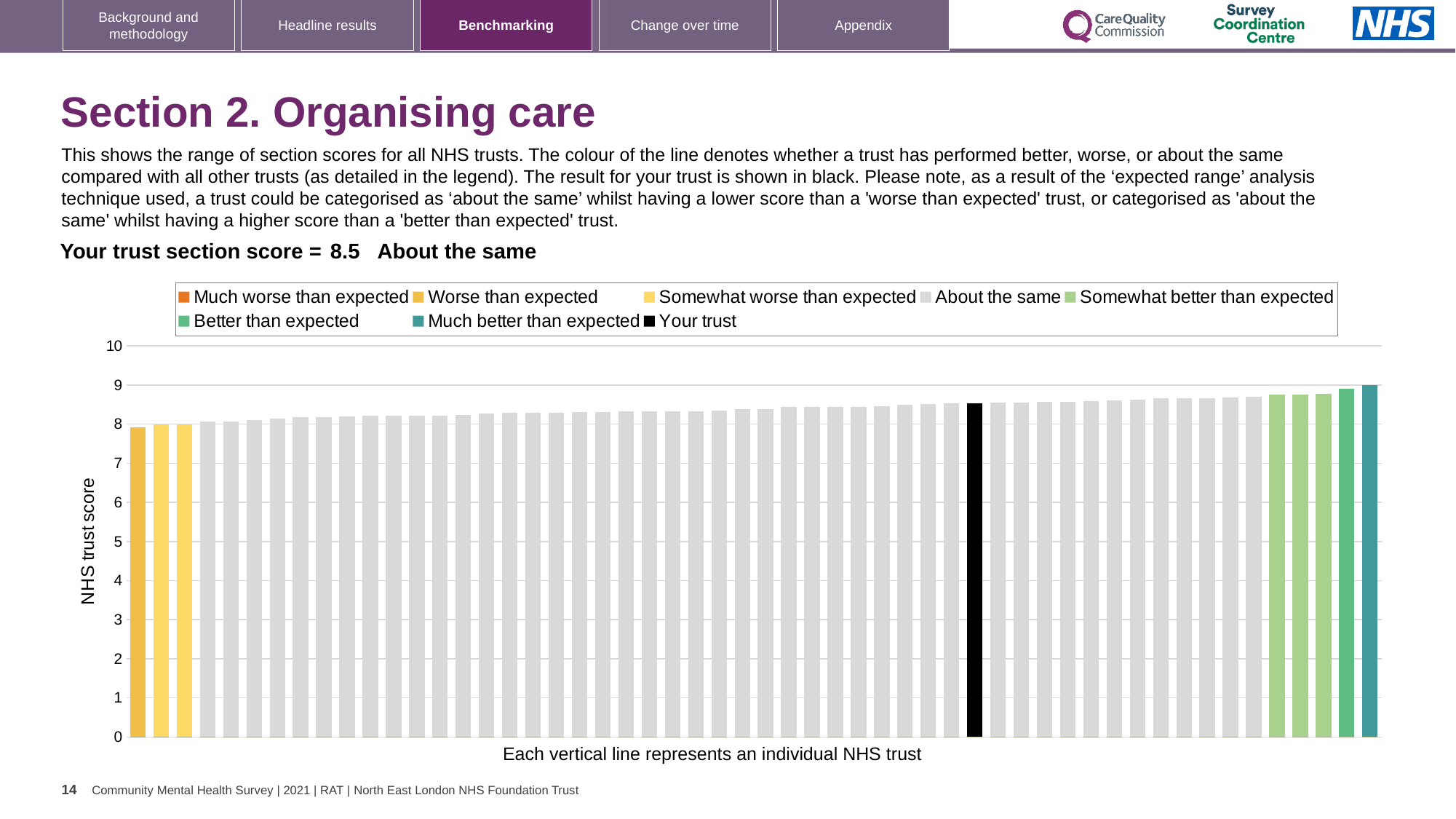
Is the value for your trust greater or less than 8? greater Which category is your trust placed in for this section? About the same Is the value of the lowest bar greater or less than 7? greater What is the title of the vertical axis? NHS trust score Is the value of the highest bar greater or less than 9.5? less What is the section score for your trust? 8.5 Is the bar for your trust higher or lower than the leftmost bar? Higher How many bars are coloured yellow? 3 How many entries does the chart legend list? 8 Do the bar values rise or fall from left to right along the x axis? Rise Which legend category does the highest bar belong to? Much better than expected What kind of chart is shown on the slide? Bar chart